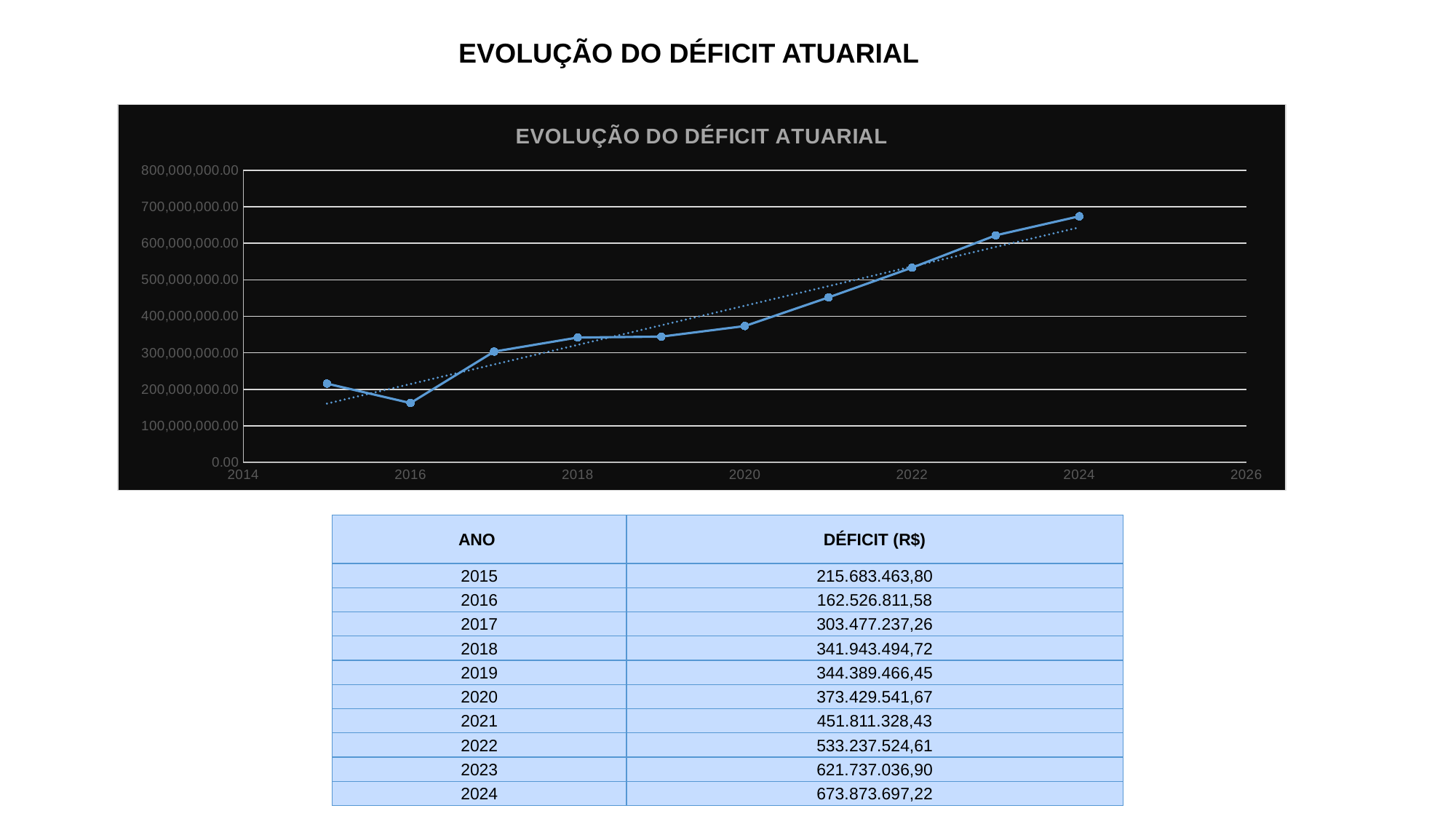
Which year has the lowest déficit value? 2016 Which year has the highest déficit value? 2024 What kind of chart is shown on the slide? line chart What is the déficit (R$) value for 2024? 673.873.697,22 What is the déficit (R$) value for 2020? 373.429.541,67 Which year has the larger déficit value, 2020 or 2022? 2022 Overall, do the déficit values rise or fall from 2015 to 2024? rise What is the title of the chart? EVOLUÇÃO DO DÉFICIT ATUARIAL Is the value for 2021 greater or less than 400,000,000.00? greater How many data points are plotted on the line? 10 What is the difference between the déficit values for 2024 and 2023? 52.136.660,32 What is the déficit (R$) value for 2016? 162.526.811,58